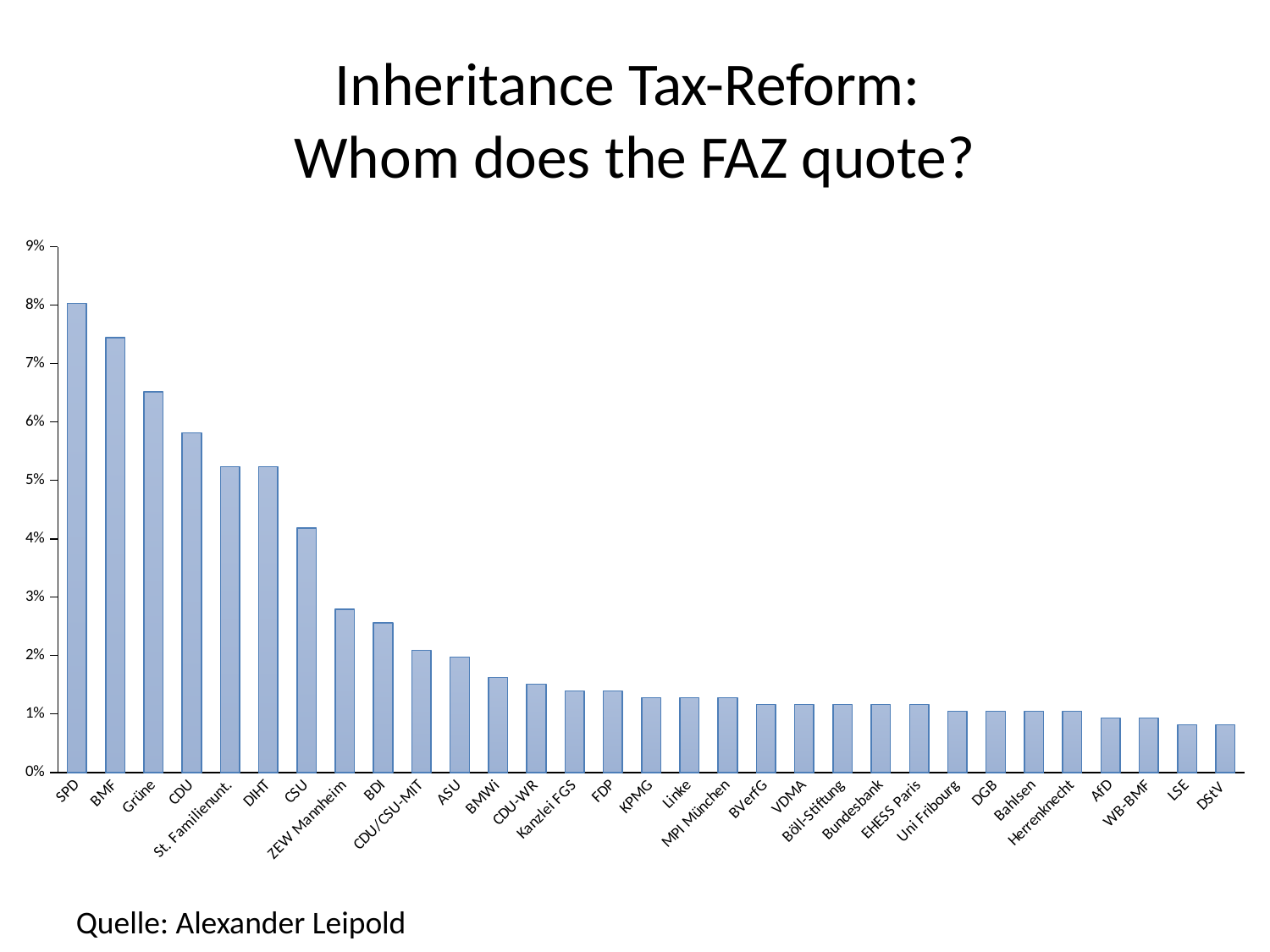
Which has the larger value, BMF or Grüne? BMF What kind of chart is shown on the slide? bar chart What is the title of the chart on the slide? Inheritance Tax-Reform: Whom does the FAZ quote? Is the value for BMF greater or less than 8%? less Is the value for BDI greater or less than 2%? greater Is the value for Grüne greater or less than 6%? greater How many categories are plotted on the x axis? 31 Do the values rise or fall from left to right along the x axis? fall Which category has the highest value? SPD